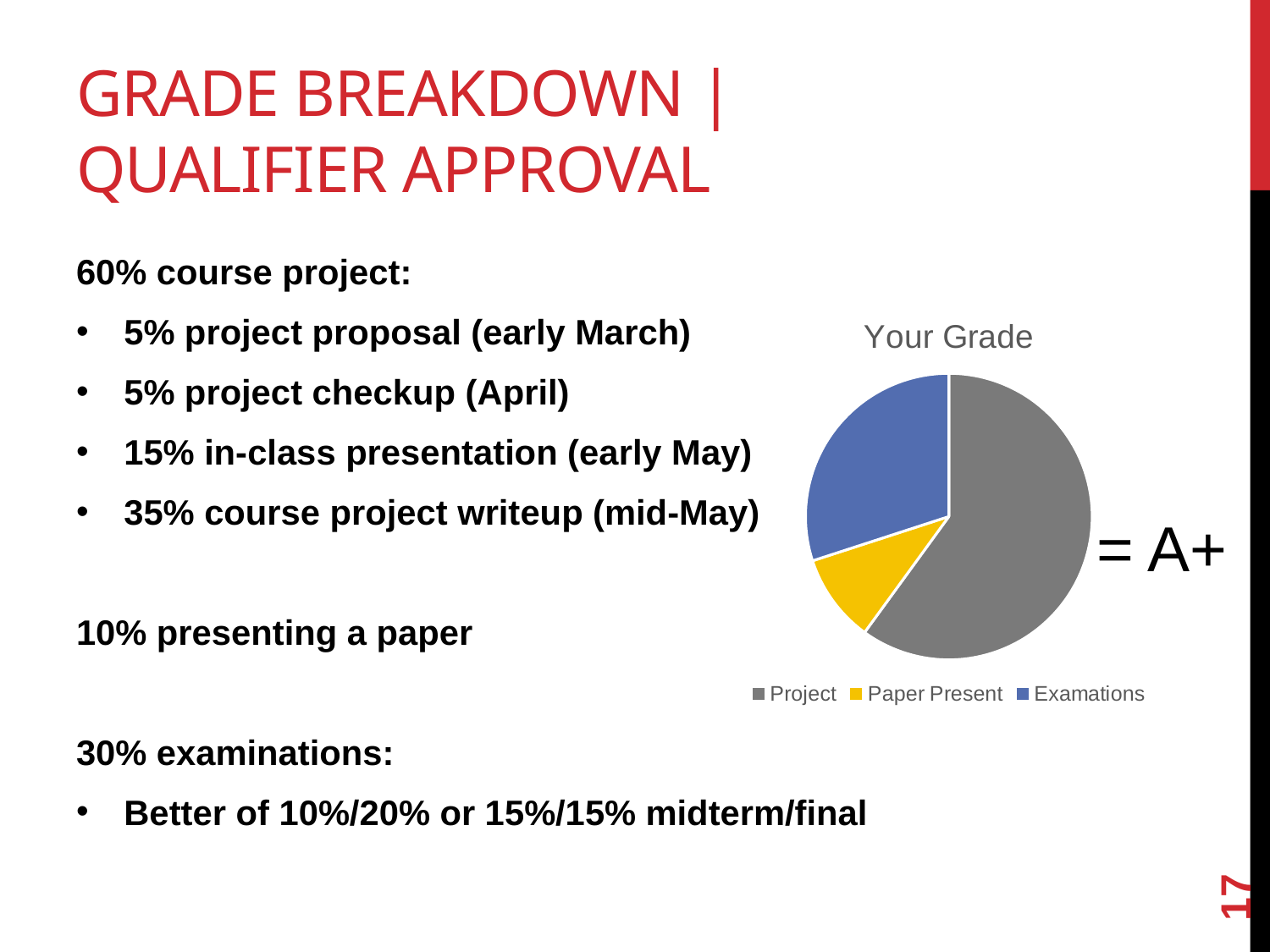
Which slice of the pie chart is the largest? Project Which slice of the pie chart is the smallest? Paper Present How many entries does the chart legend list? 3 What is the title of the chart? Your Grade Which slice is larger, Project or Examations? Project According to the slide, what share of the grade does the Examations slice represent? 30% What kind of chart is shown on the slide? pie chart Which slice is larger, Examations or Paper Present? Examations According to the slide, what share of the grade does the Project slice represent? 60% According to the slide, what share of the grade does the Paper Present slice represent? 10% How many slices does the pie chart have? 3 What colour is the Project slice in the pie chart? grey